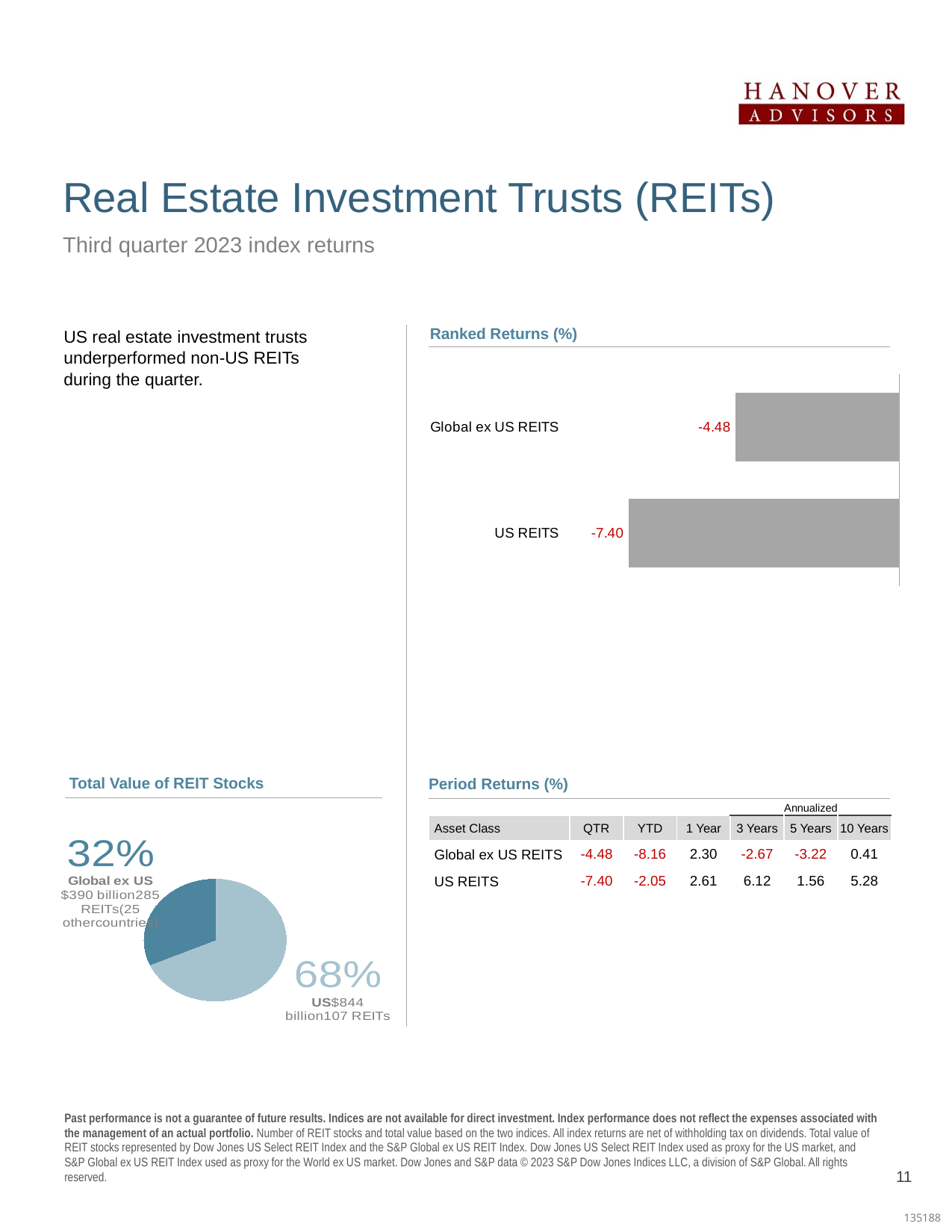
What kind of chart is the Ranked Returns (%) chart? Bar chart How many slices does the Total Value of REIT Stocks pie chart have? 2 In the Total Value of REIT Stocks pie chart, what share does the US slice represent? 68% In the Ranked Returns (%) chart, what is the value for Global ex US REITS? -4.48 In the Ranked Returns (%) chart, which category has the highest value? Global ex US REITS In the Ranked Returns (%) chart, what is the difference between the Global ex US REITS value and the US REITS value? 2.92 In the Ranked Returns (%) chart, which is larger, the value for Global ex US REITS or the value for US REITS? Global ex US REITS In the Ranked Returns (%) chart, what is the value for US REITS? -7.40 How many categories are shown in the Ranked Returns (%) chart? 2 In the Ranked Returns (%) chart, which category has the lowest value? US REITS In the Total Value of REIT Stocks pie chart, what share does the Global ex US slice represent? 32% What kind of chart is the Total Value of REIT Stocks chart? Pie chart